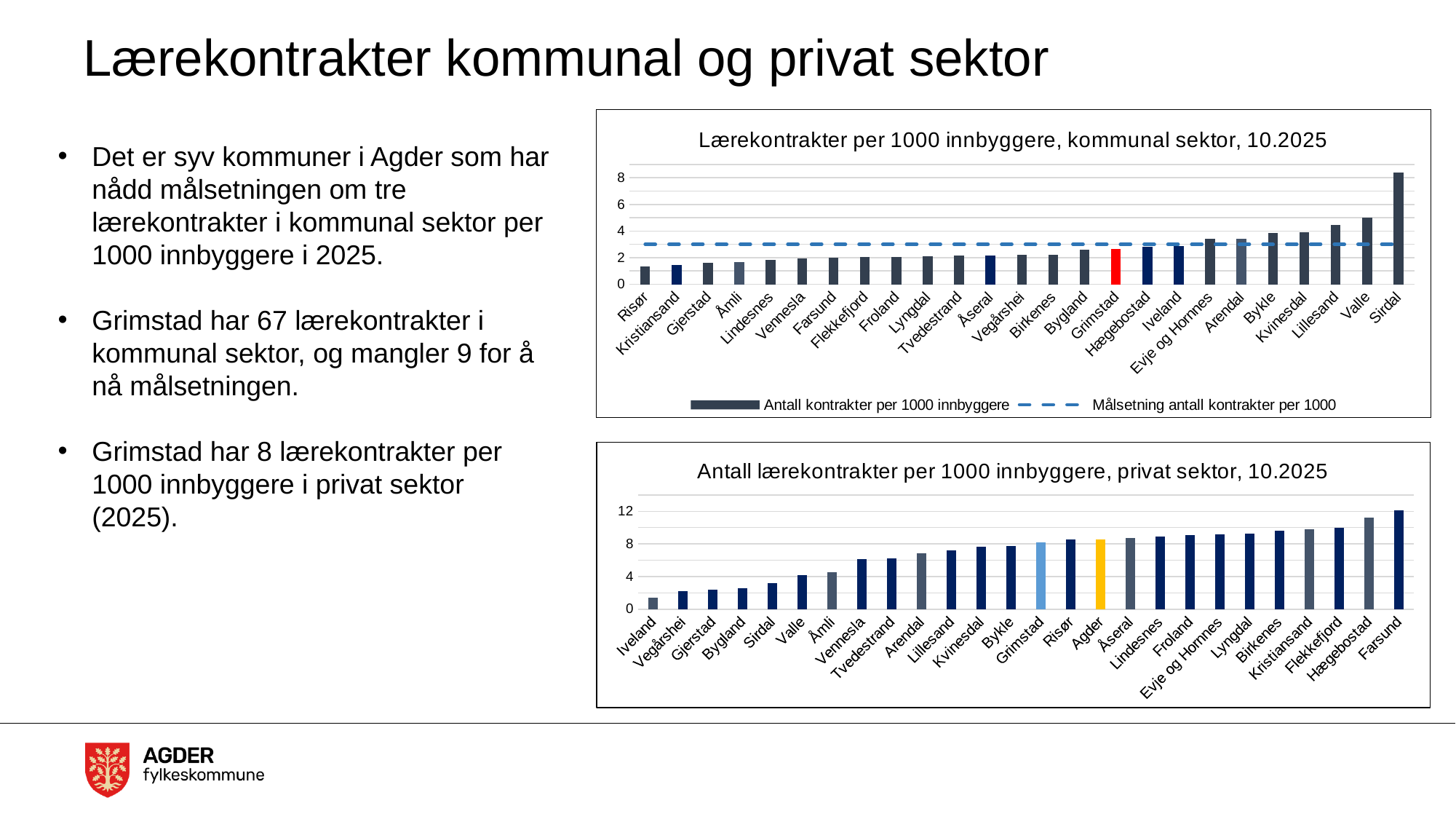
In the bottom chart (privat sektor), is the value for Grimstad greater or less than 4? greater What kind of chart is the bottom chart (privat sektor)? Bar chart In the bottom chart (privat sektor), is the value for Iveland greater or less than 4? less In the top chart (kommunal sektor), is the value for Sirdal greater or less than 6? greater In the top chart (kommunal sektor), which municipality has the lowest value? Risør In the bottom chart (privat sektor), which municipality has the lowest value? Iveland How many municipalities are shown in the top chart (kommunal sektor)? 25 In the bottom chart (privat sektor), which municipality has the highest value? Farsund In the top chart (kommunal sektor), which is larger, the value for Valle or the value for Sirdal? Sirdal How many entries does the legend of the top chart (kommunal sektor) list? 2 In the top chart (kommunal sektor), which municipality has the highest value? Sirdal